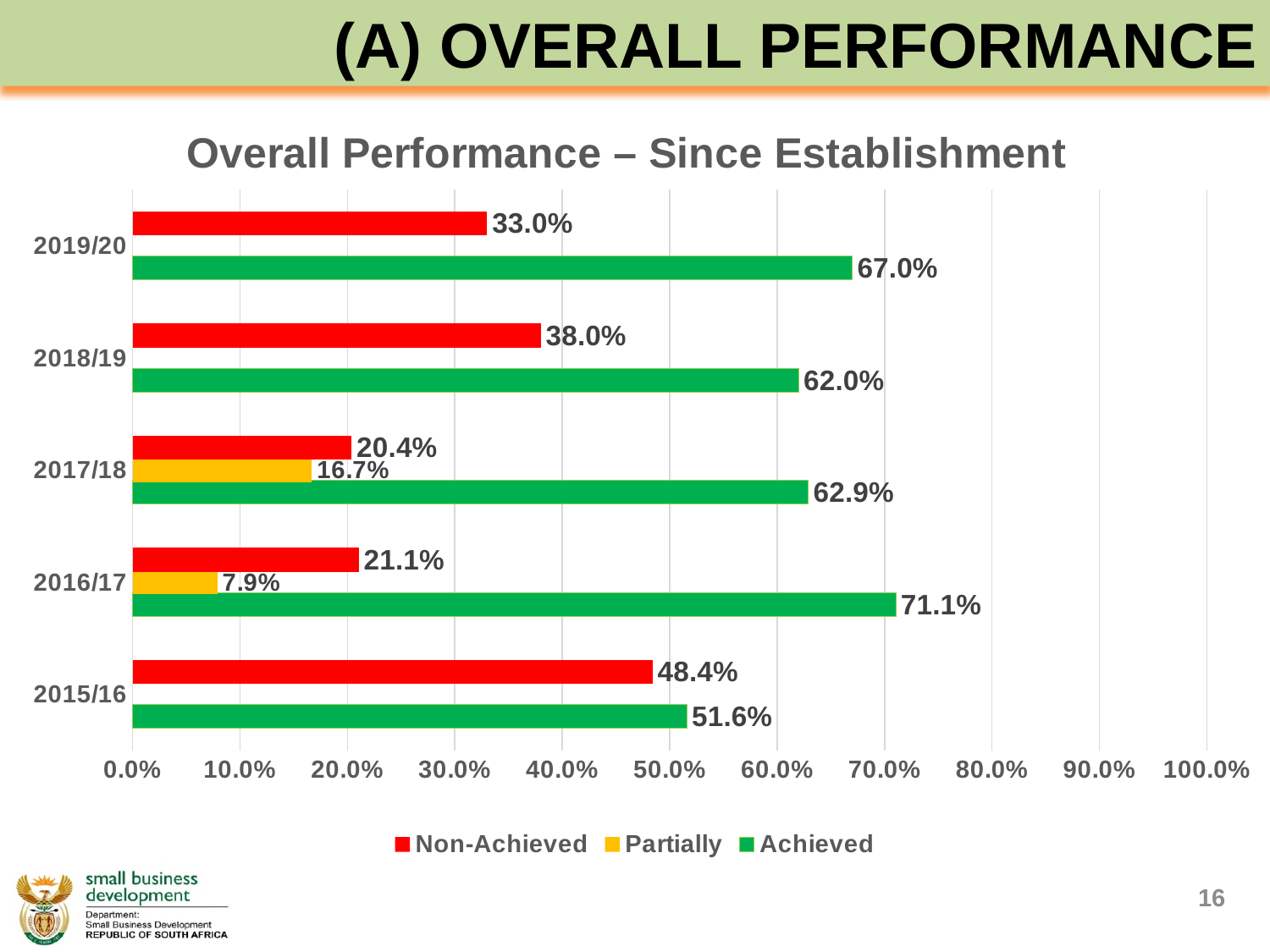
What is the Non-Achieved value for 2015/16? 48.4% Which is larger, the Non-Achieved value for 2019/20 or the Non-Achieved value for 2018/19? 2018/19 Which year has the highest Achieved value? 2016/17 Which year has the lowest Achieved value? 2015/16 What kind of chart is shown on the slide? Bar chart What is the Partially value for 2016/17? 7.9% What is the Achieved value for 2019/20? 67.0% Is the Achieved value for 2017/18 greater or less than 60.0%? greater How many years are shown on the chart? 5 How many series does the legend list? 3 What is the title of the chart? Overall Performance – Since Establishment What is the difference between the Achieved and Non-Achieved values for 2018/19? 24.0%